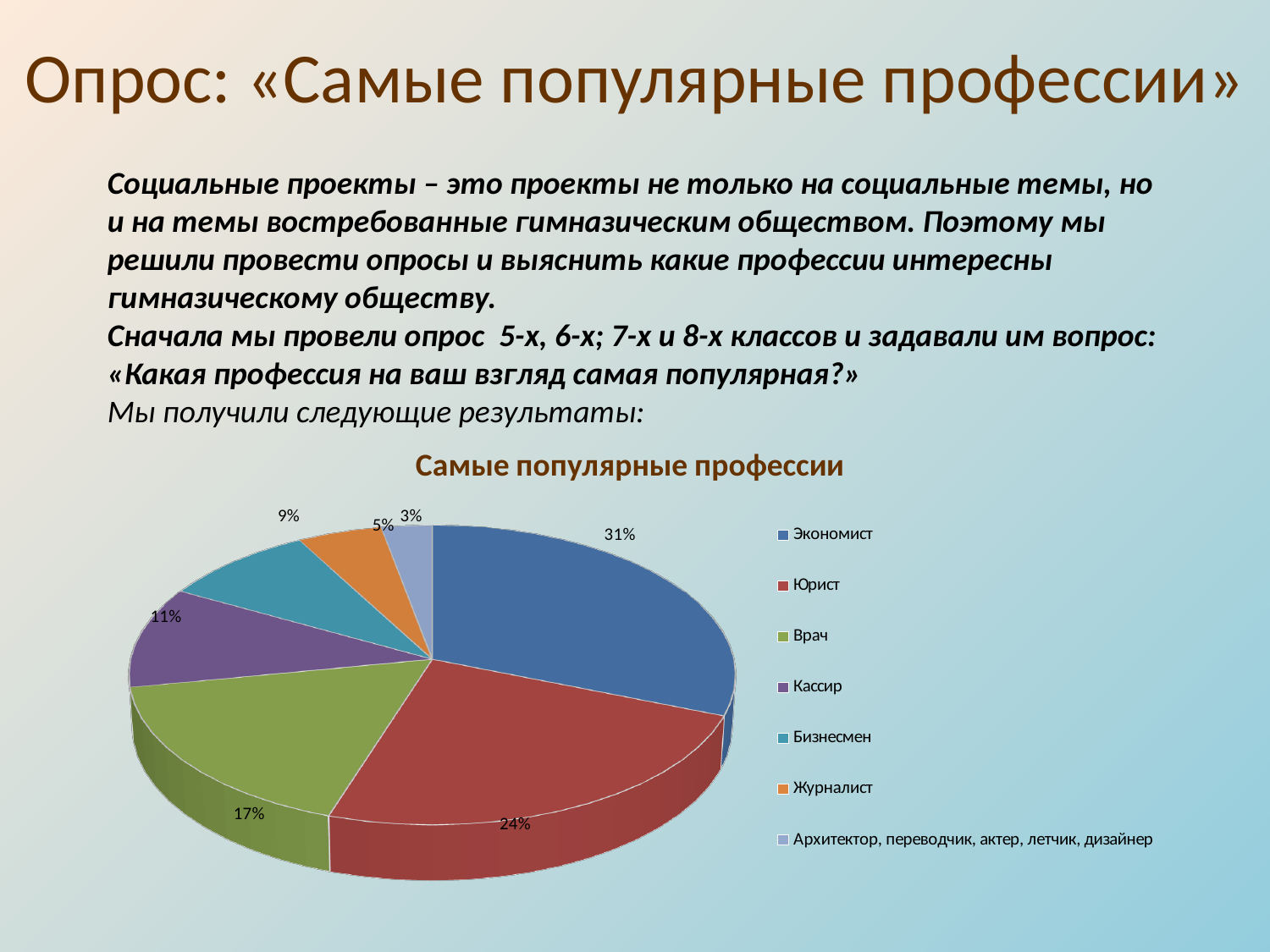
Which profession has the largest slice of the pie? Экономист What share of the pie does Врач have? 17% What share of the pie does Юрист have? 24% What share of the pie does Бизнесмен have? 9% What is the title of the chart? Самые популярные профессии What is the difference between the shares for Экономист and Юрист? 7% What share of the pie does Журналист have? 5% How many categories does the legend list? 7 What share of the pie does Кассир have? 11% Which category has the smallest slice of the pie? Архитектор, переводчик, актер, летчик, дизайнер What kind of chart is shown on the slide? pie chart What share of the pie does Экономист have? 31%